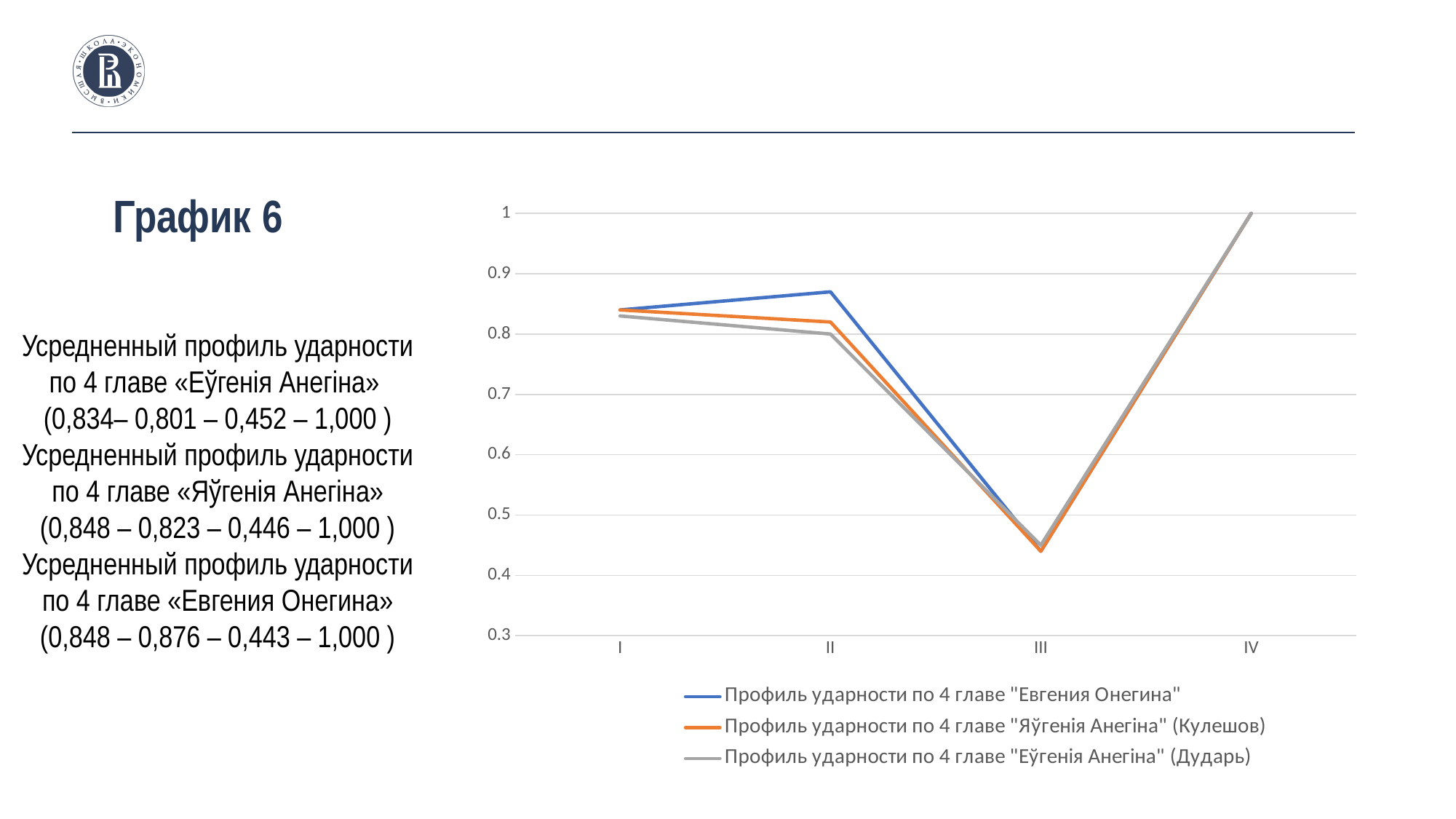
Is the value at III for the series "Профиль ударности по 4 главе "Еўгенія Анегіна" (Дударь)" greater or less than 0.5? less At which x-axis category does the series "Профиль ударности по 4 главе "Яўгенія Анегіна" (Кулешов)" reach its highest value? IV Do the values of all three series rise or fall from II to III? fall Is the value at II for the series "Профиль ударности по 4 главе "Евгения Онегина"" greater or less than 0.8? greater What is the value at IV for the series "Профиль ударности по 4 главе "Евгения Онегина""? 1 What colour is the line for the series "Профиль ударности по 4 главе "Яўгенія Анегіна" (Кулешов)"? orange What kind of chart is shown on the slide? line chart At which x-axis category does the series "Профиль ударности по 4 главе "Евгения Онегина"" reach its lowest value? III How many points are plotted along the x axis for each series? 4 What is the title of the chart shown on the slide? График 6 At II, which series has the larger value: "Евгения Онегина" or "Еўгенія Анегіна" (Дударь)? Евгения Онегина How many series does the legend list? 3